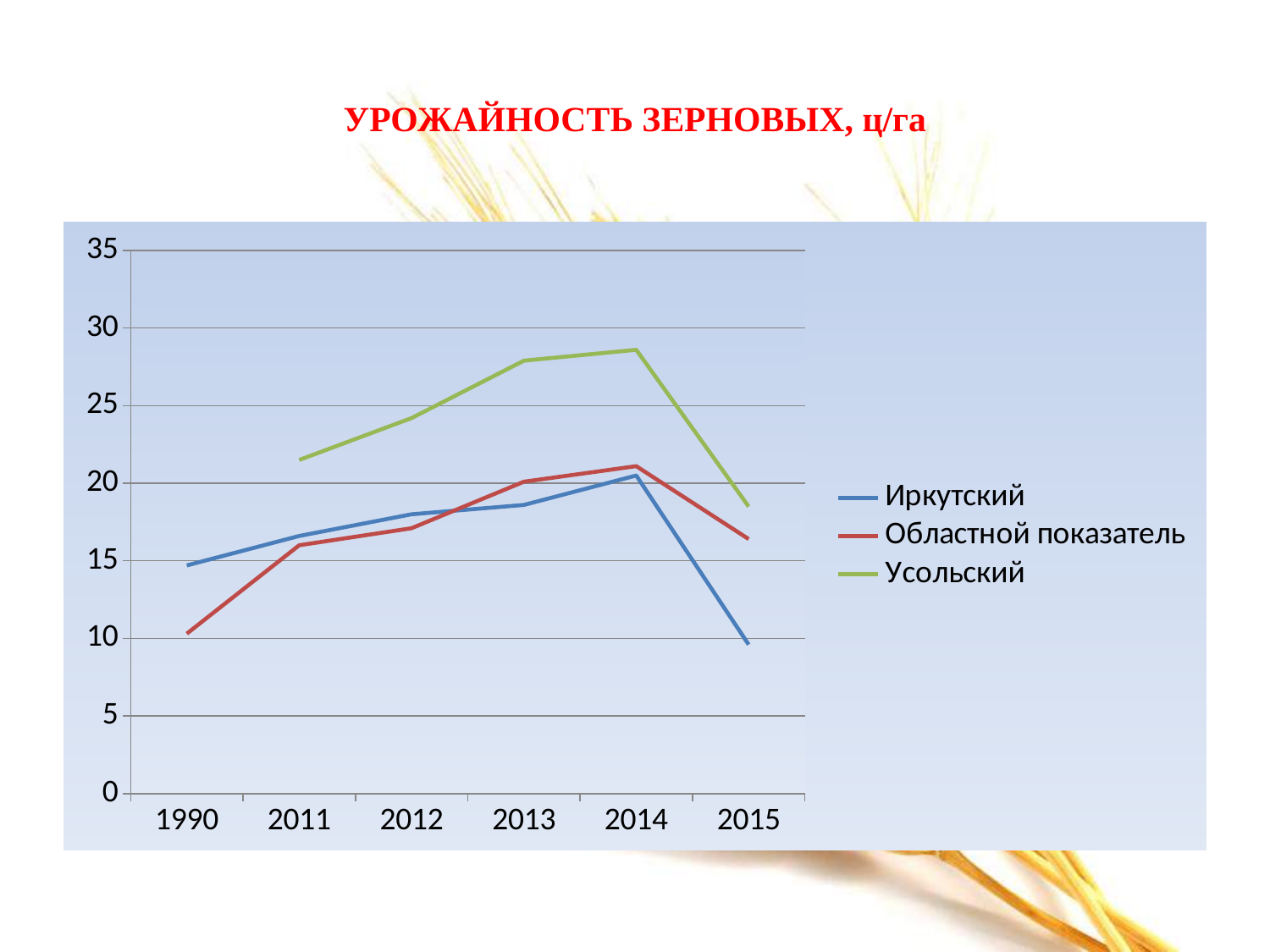
Does the Областной показатель series rise or fall from 2014 to 2015? fall Is the value for Усольский in 2014 greater or less than 25? greater Which series has the higher value in 2013, Усольский or Иркутский? Усольский Is the value for Областной показатель in 1990 greater or less than 15? less Which series is drawn with the green line? Усольский What is the title of the chart? УРОЖАЙНОСТЬ ЗЕРНОВЫХ, ц/га In which year does the Усольский series reach its highest value? 2014 Is the value for Иркутский in 2015 greater or less than 10? less How many years are shown on the x axis? 6 What kind of chart is shown on the slide? line chart In which year does the Иркутский series have its lowest value? 2015 How many series does the legend list? 3